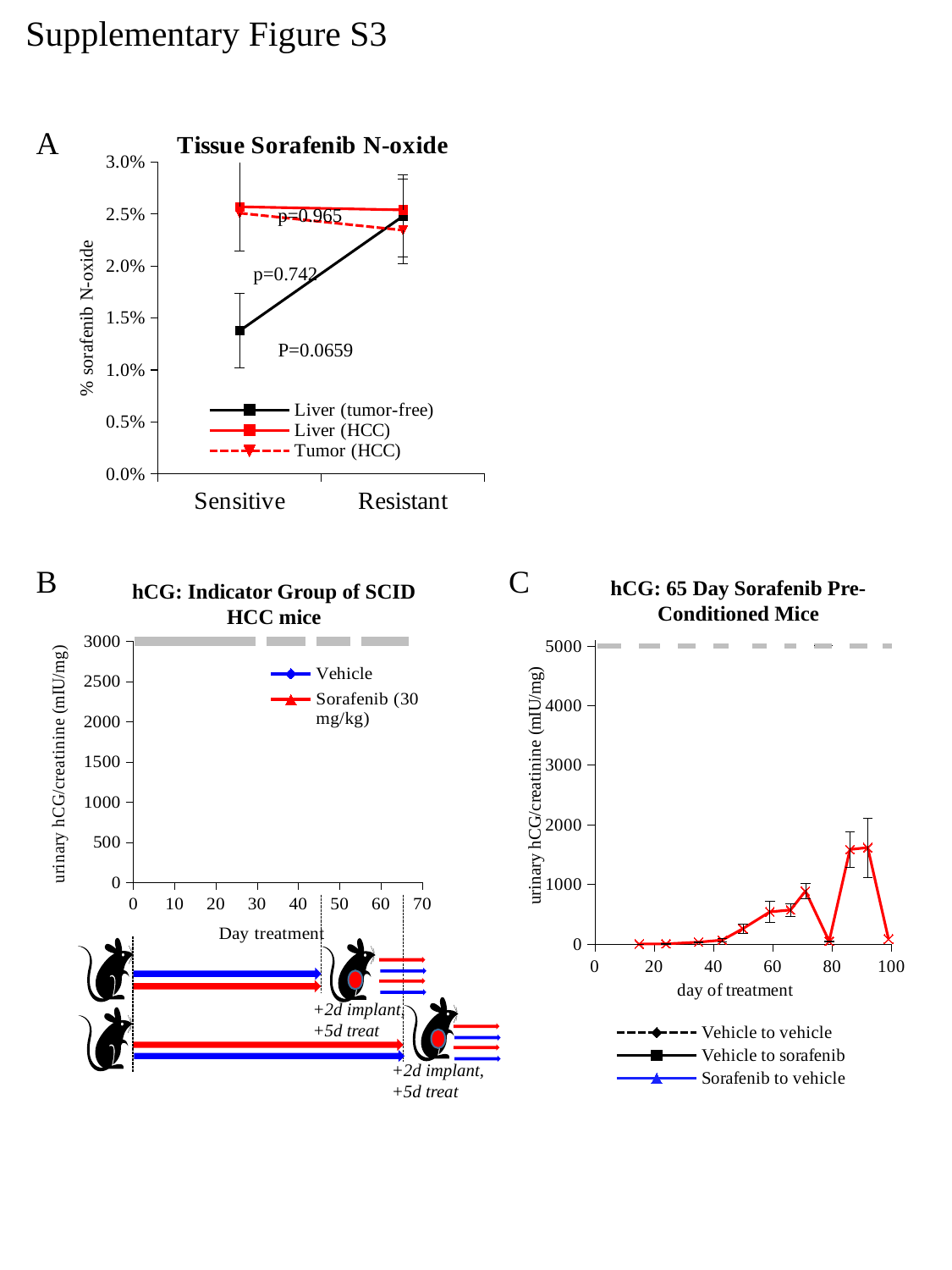
In the chart titled "Tissue Sorafenib N-oxide", at Sensitive, which is larger: Liver (HCC) or Liver (tumor-free)? Liver (HCC) In the chart titled "Tissue Sorafenib N-oxide", which series has the lowest value at Sensitive? Liver (tumor-free) In the chart titled "Tissue Sorafenib N-oxide", how many series does the legend list? 3 In the chart titled "Tissue Sorafenib N-oxide", is the value for Liver (HCC) at Sensitive greater or less than 2.0%? greater In the chart titled "Tissue Sorafenib N-oxide", which series is drawn with a dashed line? Tumor (HCC) In the chart titled "hCG: 65 Day Sorafenib Pre-Conditioned Mice", is the highest plotted value greater or less than 1000? greater In the chart titled "Tissue Sorafenib N-oxide", how many categories are on the x axis? 2 In the chart titled "Tissue Sorafenib N-oxide", is the value for Liver (tumor-free) at Sensitive greater or less than 2.0%? less In the chart titled "hCG: 65 Day Sorafenib Pre-Conditioned Mice", how many series does the legend list? 3 In the chart titled "Tissue Sorafenib N-oxide", what kind of chart is it? line chart In the chart titled "Tissue Sorafenib N-oxide", does the Liver (tumor-free) series rise or fall from Sensitive to Resistant? rise In the chart titled "hCG: Indicator Group of SCID HCC mice", how many series does the legend list? 2